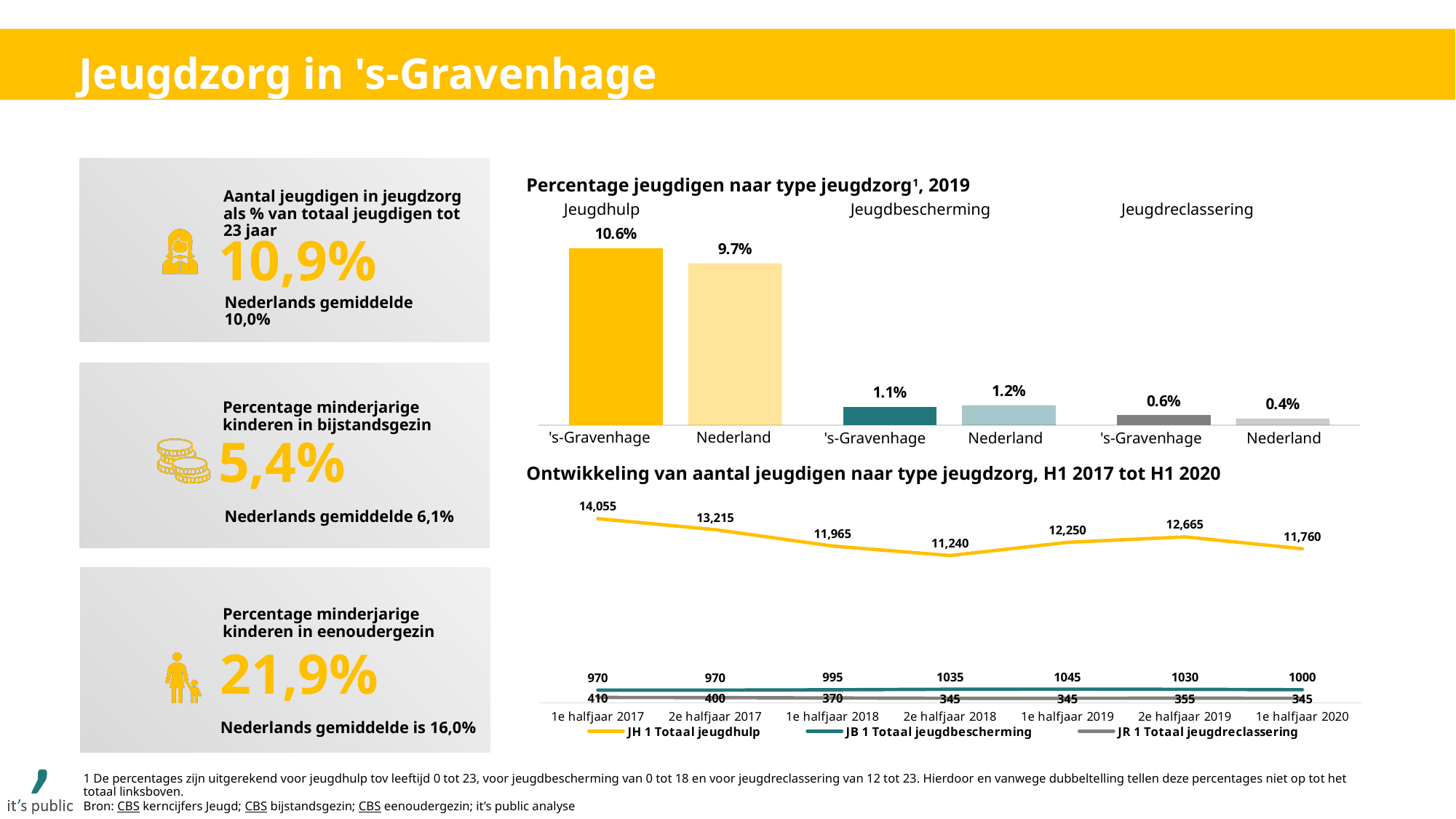
In the chart 'Percentage jeugdigen naar type jeugdzorg, 2019', which bar is the highest? Jeugdhulp 's-Gravenhage What kind of chart is 'Percentage jeugdigen naar type jeugdzorg, 2019'? Bar chart In the chart 'Ontwikkeling van aantal jeugdigen naar type jeugdzorg, H1 2017 tot H1 2020', in which period is JH 1 Totaal jeugdhulp lowest? 2e halfjaar 2018 In the chart 'Percentage jeugdigen naar type jeugdzorg, 2019', what is the difference between the Jeugdhulp percentages for 's-Gravenhage and Nederland? 0.9% In the chart 'Ontwikkeling van aantal jeugdigen naar type jeugdzorg, H1 2017 tot H1 2020', how many periods are shown on the x axis? 7 In the chart 'Ontwikkeling van aantal jeugdigen naar type jeugdzorg, H1 2017 tot H1 2020', what is the difference between JR 1 Totaal jeugdreclassering in 1e halfjaar 2017 and 1e halfjaar 2020? 65 In the chart 'Percentage jeugdigen naar type jeugdzorg, 2019', what is the Jeugdreclassering percentage for Nederland? 0.4% In the chart 'Percentage jeugdigen naar type jeugdzorg, 2019', what is the Jeugdhulp percentage for 's-Gravenhage? 10.6% In the chart 'Percentage jeugdigen naar type jeugdzorg, 2019', which is larger for Jeugdbescherming: 's-Gravenhage or Nederland? Nederland In the chart 'Ontwikkeling van aantal jeugdigen naar type jeugdzorg, H1 2017 tot H1 2020', what is the value of JH 1 Totaal jeugdhulp in 1e halfjaar 2017? 14,055 In the chart 'Ontwikkeling van aantal jeugdigen naar type jeugdzorg, H1 2017 tot H1 2020', how many series does the legend list? 3 In the chart 'Ontwikkeling van aantal jeugdigen naar type jeugdzorg, H1 2017 tot H1 2020', what is the value of JB 1 Totaal jeugdbescherming in 1e halfjaar 2019? 1045